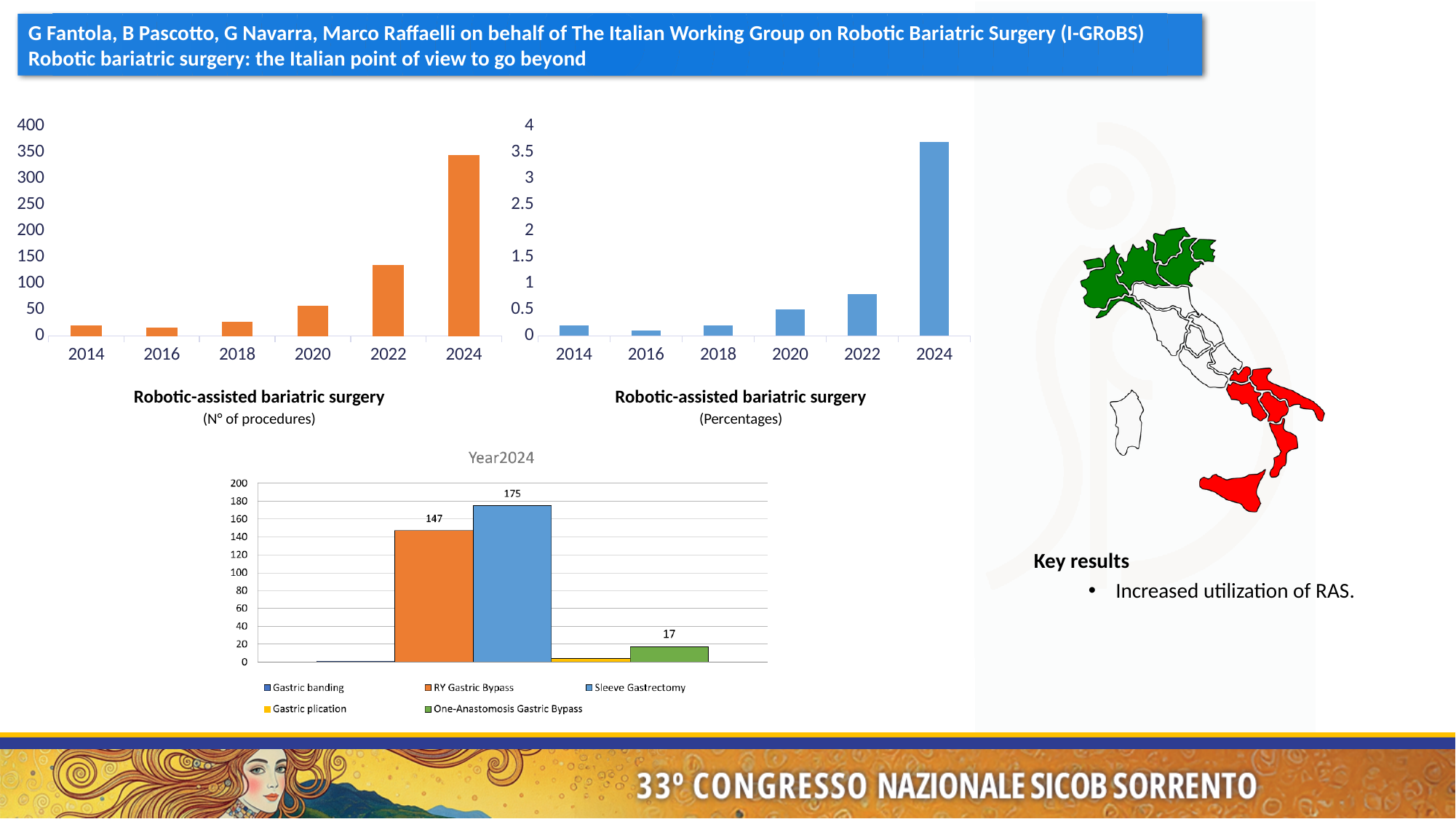
In the 'Year2024' chart, what is the value for Sleeve Gastrectomy? 175 In the 'Robotic-assisted bariatric surgery (Percentages)' chart, is the value for 2024 greater or less than 3? greater In the 'Year2024' chart, what is the difference between Sleeve Gastrectomy and RY Gastric Bypass? 28 In the 'Year2024' chart, what is the value for RY Gastric Bypass? 147 In the 'Robotic-assisted bariatric surgery (Percentages)' chart, which year has the lowest value? 2016 In the 'Robotic-assisted bariatric surgery (N° of procedures)' chart, is the value for 2024 greater or less than 300? greater In the 'Robotic-assisted bariatric surgery (N° of procedures)' chart, is the value for 2022 greater or less than 100? greater In the 'Year2024' chart, what is the value for One-Anastomosis Gastric Bypass? 17 How many series does the legend of the 'Year2024' chart list? 5 In the 'Year2024' chart, which procedure has the highest value? Sleeve Gastrectomy In the 'Robotic-assisted bariatric surgery (N° of procedures)' chart, which year has the highest value? 2024 How many years are shown on the x axis of the 'Robotic-assisted bariatric surgery (Percentages)' chart? 6